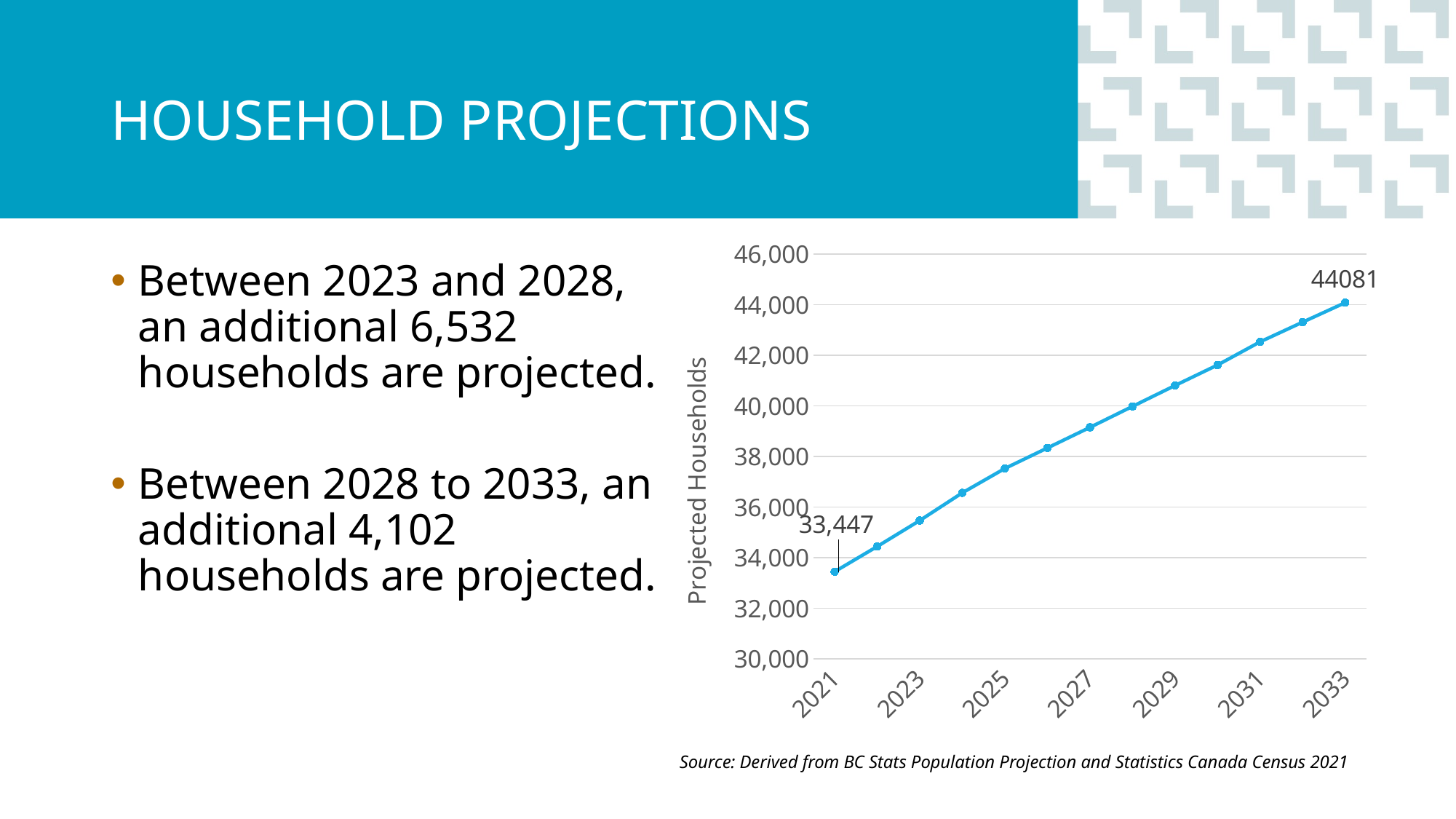
What is the projected number of households for 2033? 44081 What is the title of the vertical axis of the chart? Projected Households Is the projected value for 2031 greater or less than 40,000? greater Is the projected value for 2025 greater or less than 36,000? greater Which year has the highest projected number of households? 2033 What kind of chart is shown on the slide? Line chart Which year has the lowest projected number of households? 2021 What is the difference between the projected households in 2033 and in 2021? 10,634 What is the projected number of households for 2021? 33,447 Do the projected households rise or fall from 2021 to 2033? Rise Which year has more projected households, 2021 or 2033? 2033 How many data points are plotted on the line? 13